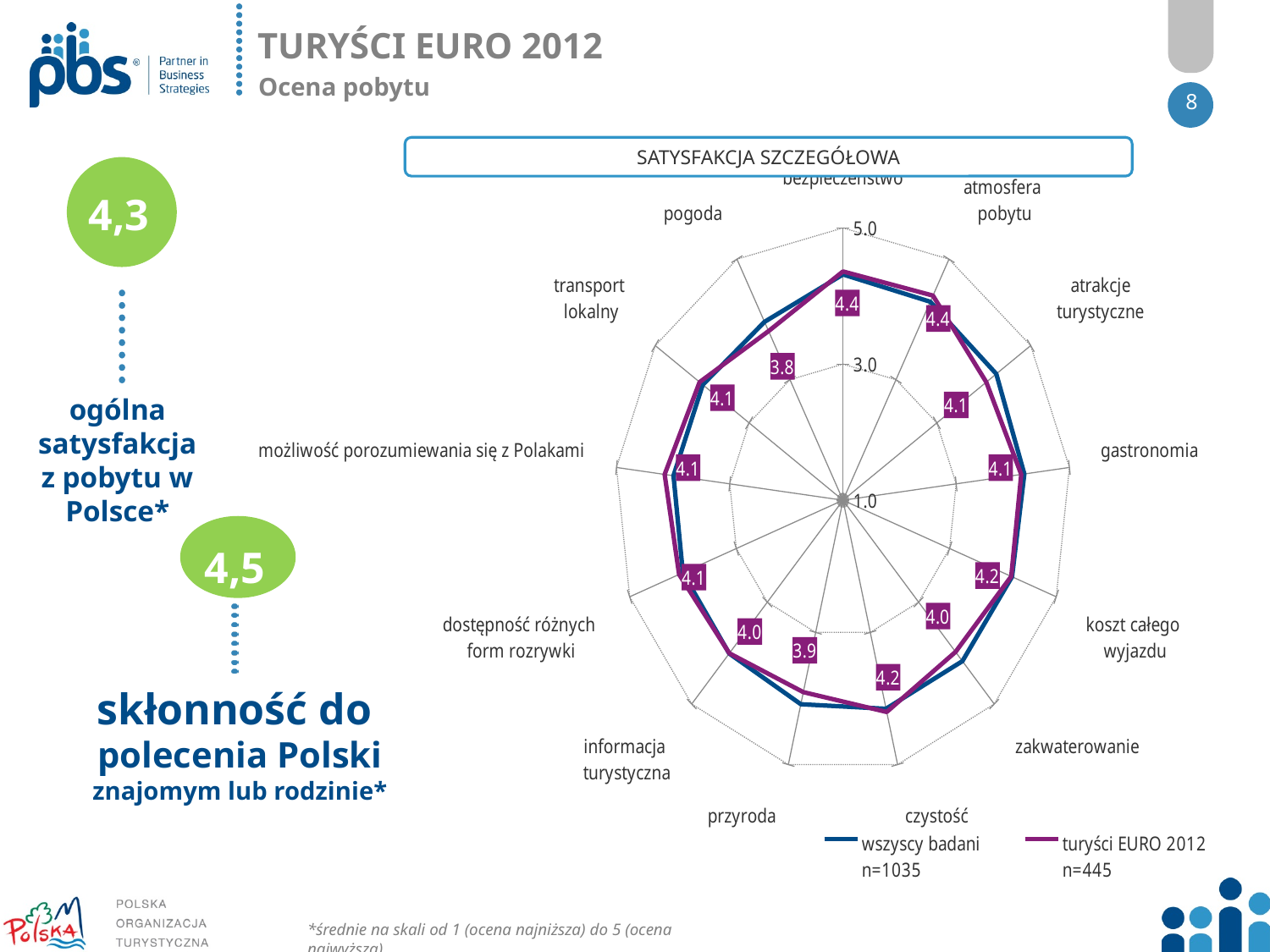
What sample size (n) does the legend give for the series 'turyści EURO 2012'? n=445 Which category has the lowest labelled value on the radar chart? pogoda According to the data labels on the radar chart, what is the value for pogoda? 3.8 On the radar chart, which has the larger labelled value: koszt całego wyjazdu or przyroda? koszt całego wyjazdu What kind of chart is shown under the title SATYSFAKCJA SZCZEGÓŁOWA? radar chart According to the data labels on the radar chart, what is the value for koszt całego wyjazdu? 4.2 How many categories (axes) does the radar chart have? 13 How many series does the legend of the radar chart list? 2 On the radar chart, is the value for pogoda greater or less than 3.0? greater According to the data labels on the radar chart, what is the value for przyroda? 3.9 According to the data labels on the radar chart, what is the value for bezpieczeństwo? 4.4 What is the difference between the labelled values for bezpieczeństwo and pogoda on the radar chart? 0.6